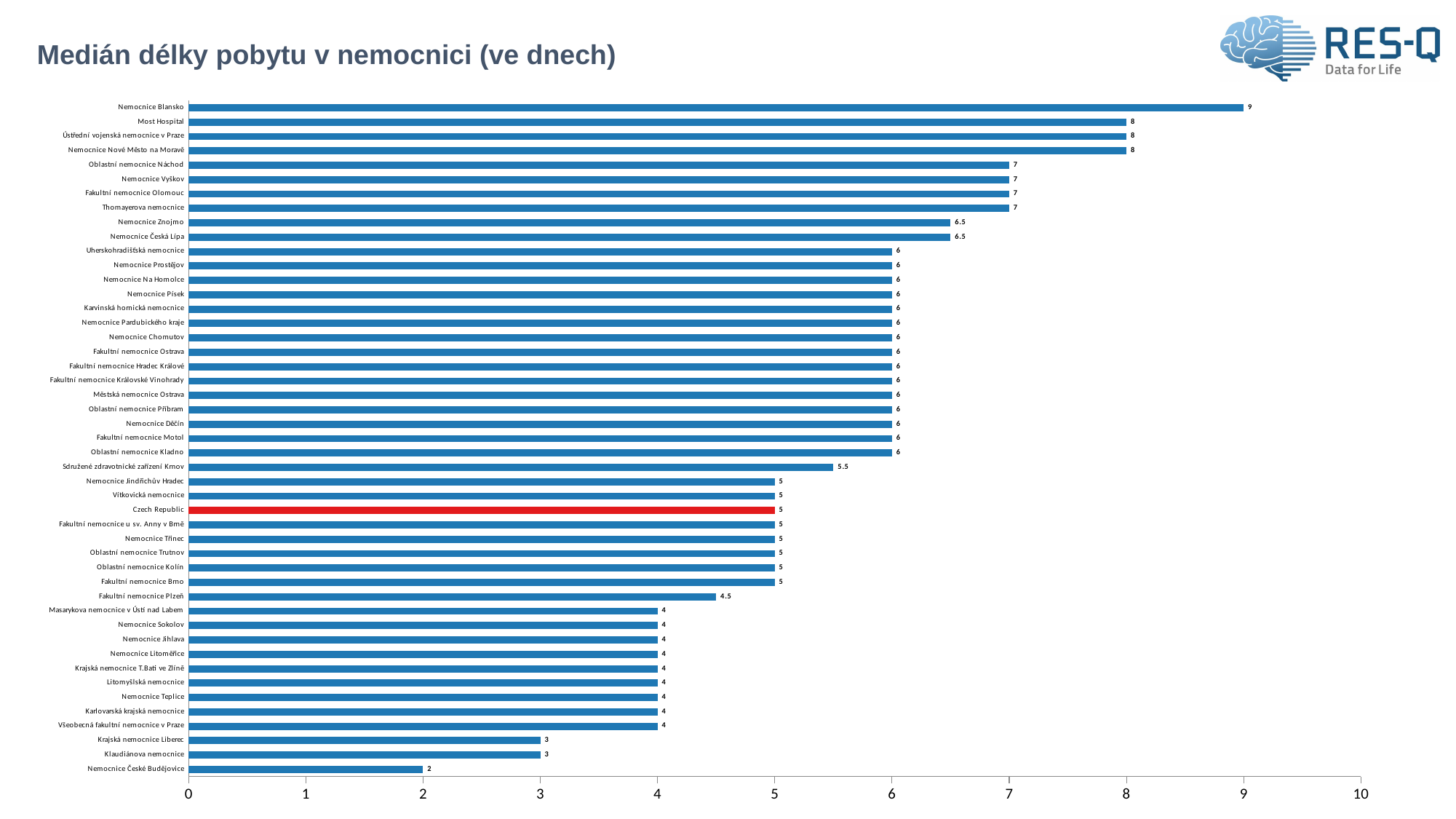
What is the value for Fakultní nemocnice Plzeň? 4.5 Which hospital has the highest median length of stay? Nemocnice Blansko What kind of chart is shown on the slide? bar chart What is the value for Sdružené zdravotnické zařízení Krnov? 5.5 What is the title of the chart? Medián délky pobytu v nemocnici (ve dnech) What is the difference between the values for Nemocnice Blansko and Nemocnice České Budějovice? 7 What is the value shown for Czech Republic? 5 Which hospital has the lowest median length of stay? Nemocnice České Budějovice Which bar is highlighted in red? Czech Republic Which is larger, the value for Most Hospital or the value for Nemocnice Znojmo? Most Hospital Is the value for Thomayerova nemocnice greater or less than 6? greater What is the median length of hospital stay for Nemocnice Blansko? 9